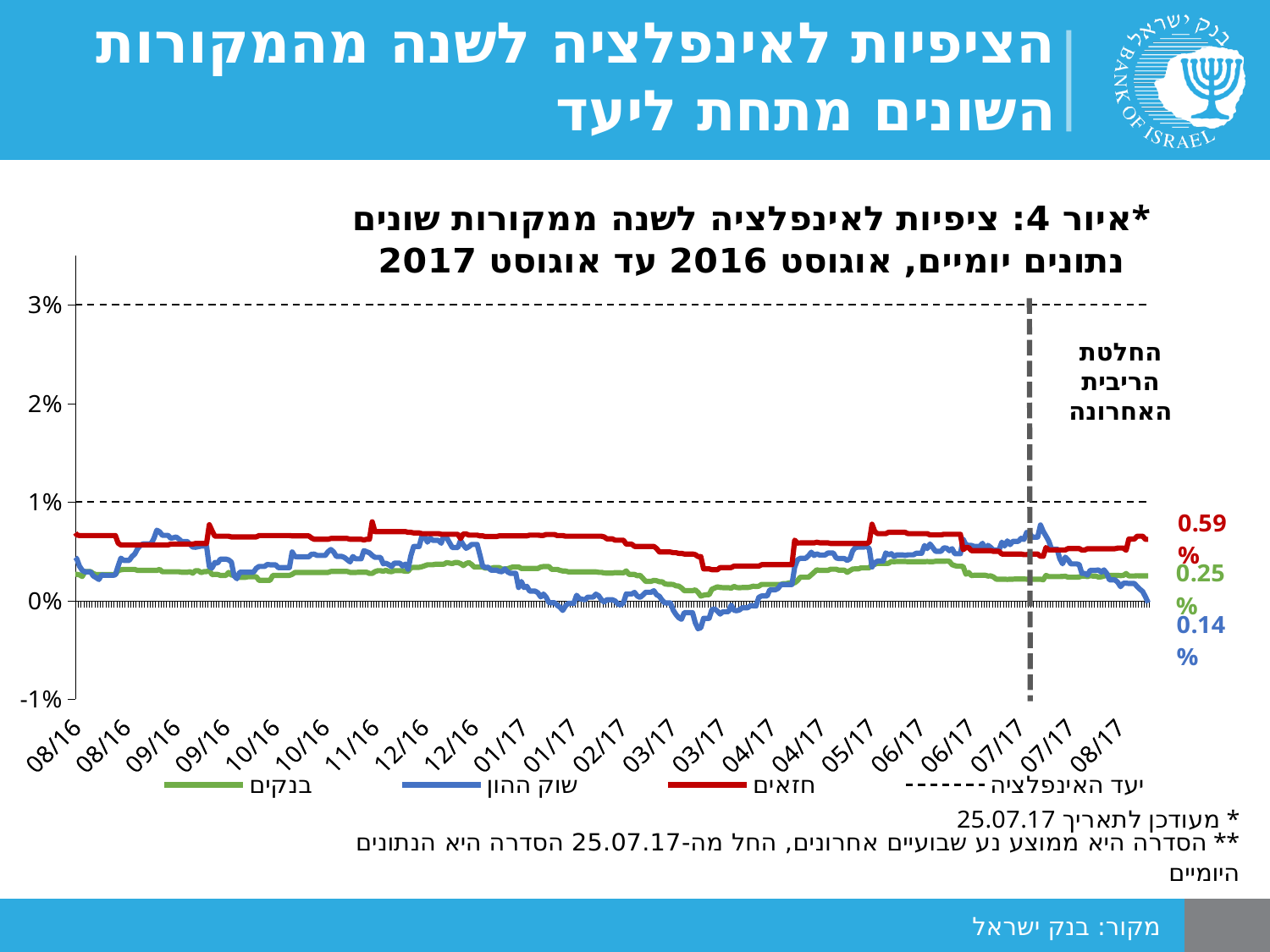
What does the vertical dashed line on the chart mark, according to its label? החלטת הריבית האחרונה Which labelled end value is larger, בנקים or שוק ההון? בנקים What is the difference between the labelled end values of חזאים (0.59%) and בנקים (0.25%)? 0.34 percentage points What is the latest value labelled for the חזאים (forecasters) series? 0.59% What type of chart is shown on the slide? Line chart Does the שוק ההון series rise or fall between 07/17 and 08/17? fall Which series has the lowest labelled end value? שוק ההון What is the latest value labelled for the שוק ההון (capital market) series? 0.14% What is the latest value labelled for the בנקים (banks) series? 0.25% How many entries does the chart legend list? 4 Which series has the highest labelled end value? חזאים Is the value of the שוק ההון series around 03/17 greater or less than 0%? less